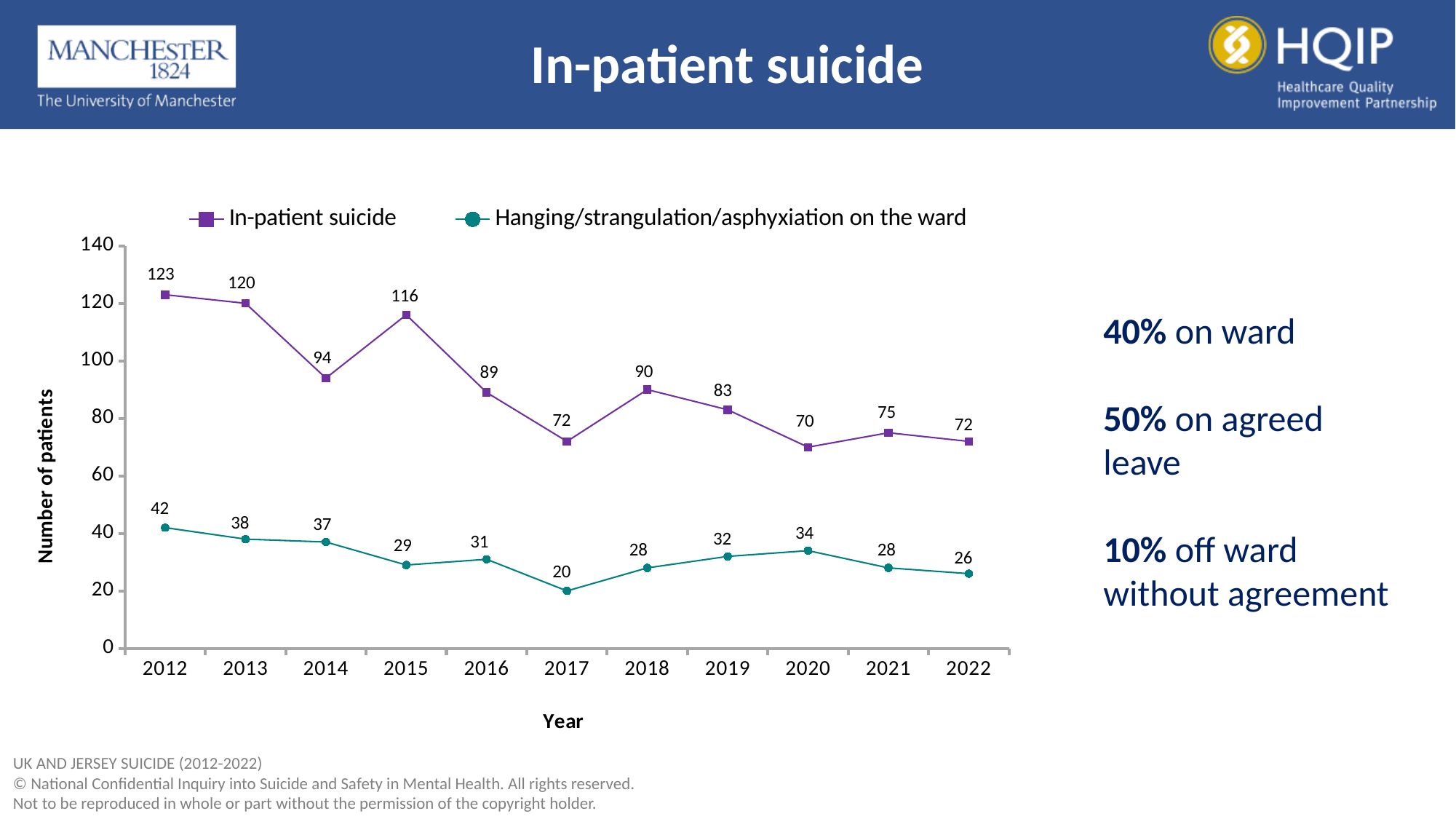
What is the value for In-patient suicide in 2020? 70 What is the label of the y axis? Number of patients What kind of chart is shown on the slide? Line chart What is the value for Hanging/strangulation/asphyxiation on the ward in 2017? 20 How many series does the legend list? 2 In which year is the Hanging/strangulation/asphyxiation on the ward series lowest? 2017 What is the difference between In-patient suicide and Hanging/strangulation/asphyxiation on the ward in 2022? 46 How many years are plotted on the x axis? 11 What is the value for In-patient suicide in 2012? 123 Which is larger, the In-patient suicide value in 2015 or in 2016? 2015 Does the In-patient suicide series generally rise or fall from 2012 to 2022? Fall In which year is the In-patient suicide series highest? 2012